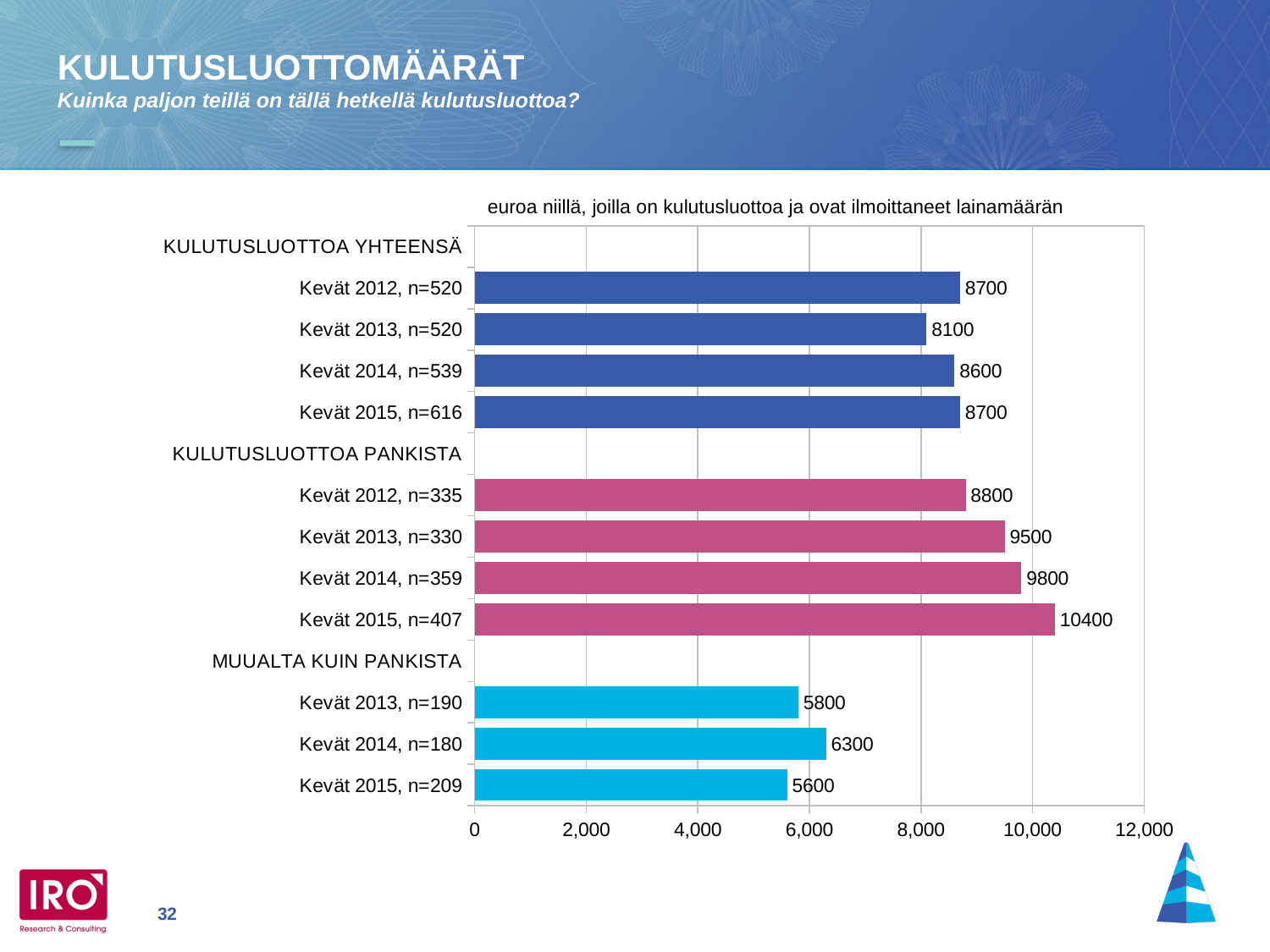
What is the value for Kevät 2015, n=407 under KULUTUSLUOTTOA PANKISTA? 10400 What kind of chart is shown on the slide? bar chart What is the difference between the KULUTUSLUOTTOA PANKISTA values for Kevät 2015, n=407 and Kevät 2012, n=335? 1600 How many bars are plotted on the chart? 11 What colour are the bars in the KULUTUSLUOTTOA PANKISTA group? pink/magenta Which bar has the lowest value on the chart? Kevät 2015, n=209 (MUUALTA KUIN PANKISTA) Which is larger: the MUUALTA KUIN PANKISTA value for Kevät 2013, n=190 or for Kevät 2015, n=209? Kevät 2013, n=190 Is the value for Kevät 2014, n=359 under KULUTUSLUOTTOA PANKISTA greater or less than 8,000? greater Which bar has the highest value on the chart? Kevät 2015, n=407 (KULUTUSLUOTTOA PANKISTA) What is the value for Kevät 2014, n=180 under MUUALTA KUIN PANKISTA? 6300 Do the KULUTUSLUOTTOA PANKISTA values rise or fall from Kevät 2012 to Kevät 2015? rise What is the value for Kevät 2013, n=520 under KULUTUSLUOTTOA YHTEENSÄ? 8100